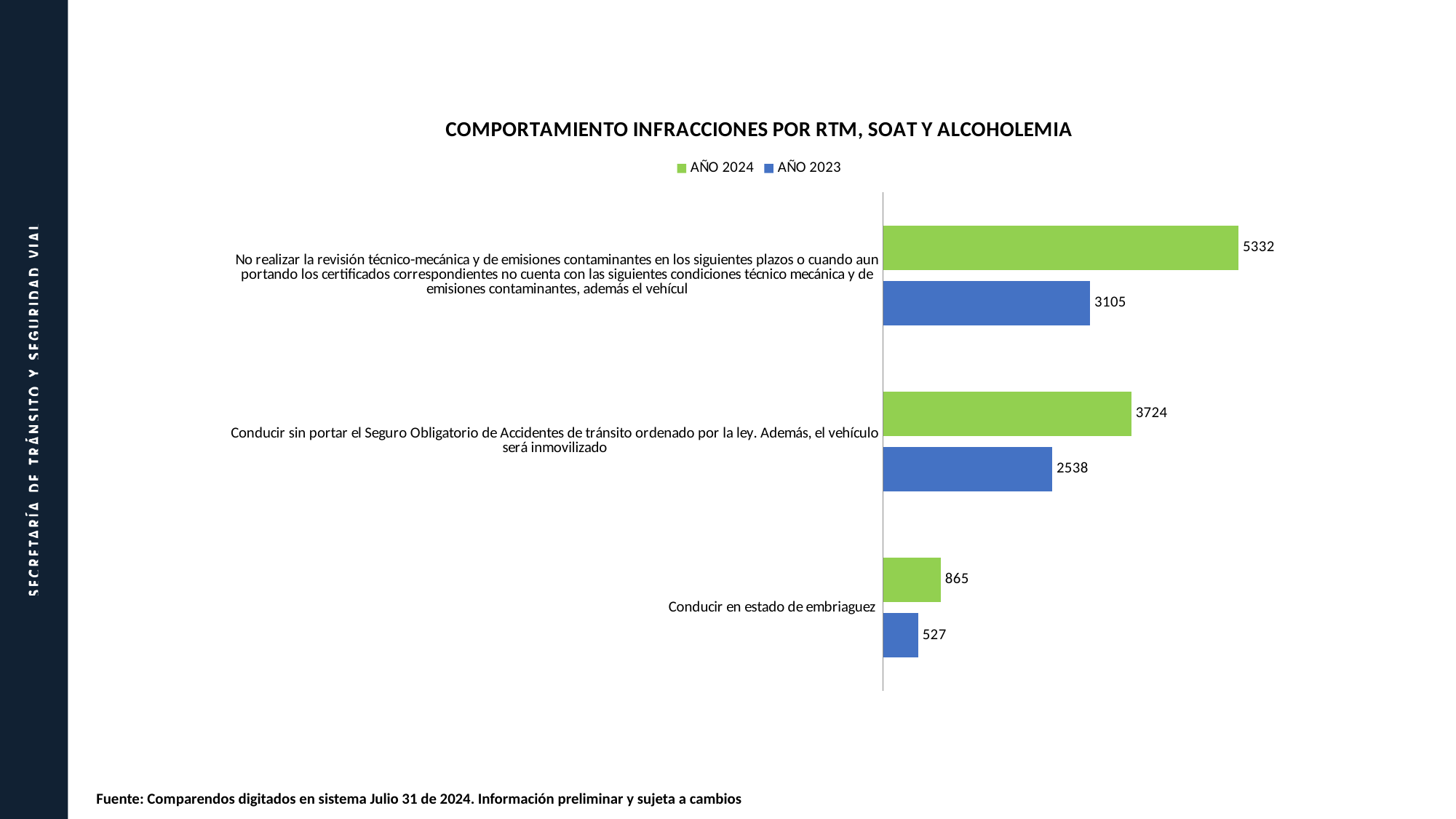
Which category has the highest AÑO 2024 value? No realizar la revisión técnico-mecánica y de emisiones contaminantes... What type of chart is shown on the slide? Bar chart What is the AÑO 2024 value for 'Conducir en estado de embriaguez'? 865 Which category has the lowest AÑO 2023 value? Conducir en estado de embriaguez What is the AÑO 2023 value for 'Conducir en estado de embriaguez'? 527 What is the AÑO 2023 value for the category about not performing the technical-mechanical review ('No realizar la revisión técnico-mecánica...')? 3105 What is the difference between the AÑO 2024 and AÑO 2023 values for 'Conducir en estado de embriaguez'? 338 What is the difference between the AÑO 2024 and AÑO 2023 values for the technical-mechanical review category? 2227 For the SOAT category, which is larger: the AÑO 2024 value or the AÑO 2023 value? AÑO 2024 What is the AÑO 2024 value for the category about driving without SOAT ('Conducir sin portar el Seguro Obligatorio de Accidentes de tránsito...')? 3724 How many series does the legend list? 2 How many categories are shown in the chart? 3